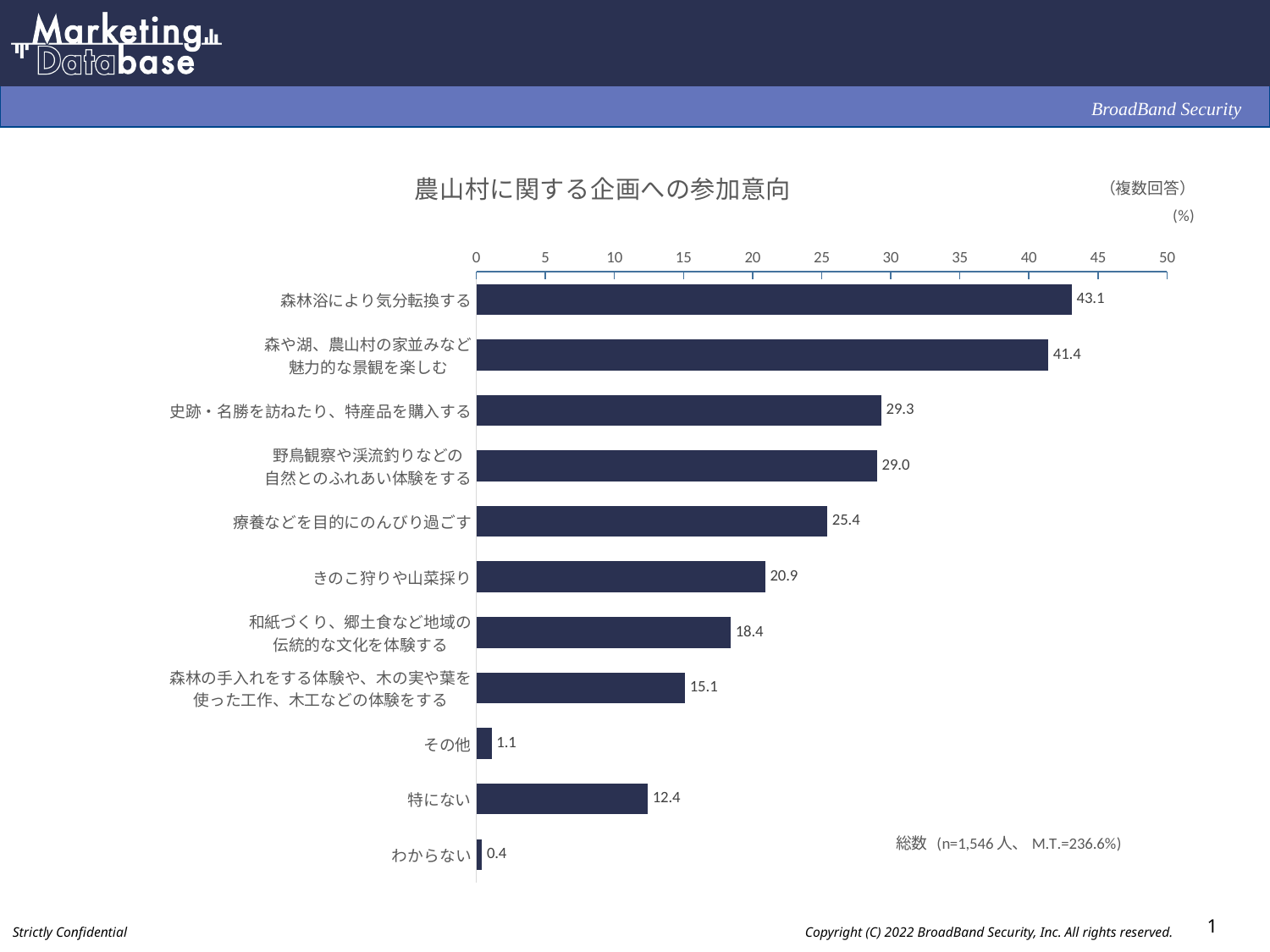
Which is larger, the value for 和紙づくり、郷土食など地域の伝統的な文化を体験する or the value for 特にない? 和紙づくり、郷土食など地域の伝統的な文化を体験する Which category has the highest value? 森林浴により気分転換する What is the title of the chart? 農山村に関する企画への参加意向 What is the value for 療養などを目的にのんびり過ごす? 25.4 What is the difference between the values for 森林浴により気分転換する and 森や湖、農山村の家並みなど魅力的な景観を楽しむ? 1.7 Is the value for 史跡・名勝を訪ねたり、特産品を購入する greater or less than 25? greater How many categories are shown in the chart? 11 What is the value for 森林浴により気分転換する? 43.1 What is the value for 特にない? 12.4 What kind of chart is shown on the slide? bar chart Which category has the lowest value? わからない What is the value for きのこ狩りや山菜採り? 20.9